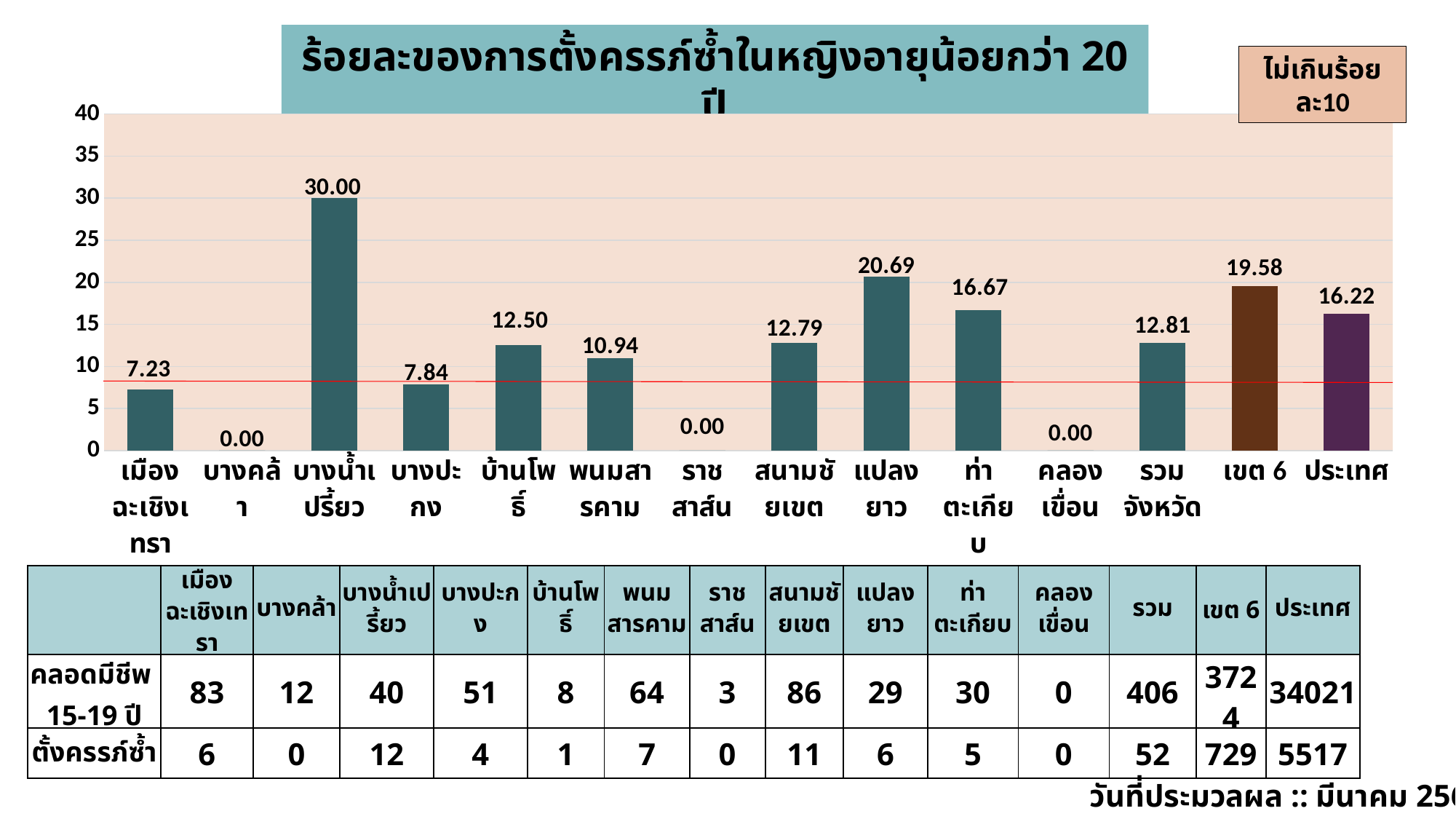
What kind of chart is shown on the slide? bar chart What is the value for บางน้ำเปรี้ยว? 30.00 Which category has the highest value? บางน้ำเปรี้ยว Which is larger, the value for สนามชัยเขต or the value for บ้านโพธิ์? สนามชัยเขต What is the value for ประเทศ? 16.22 What is the value for แปลงยาว? 20.69 Is the value for รวมจังหวัด greater or less than 10? greater What is the value for เขต 6? 19.58 How many categories have a value of 0.00? 3 What is the title of the chart? ร้อยละของการตั้งครรภ์ซ้ำในหญิงอายุน้อยกว่า 20 ปี How many categories are shown on the x axis of the chart? 14 What is the difference between the values for ท่าตะเกียบ and บางปะกง? 8.83